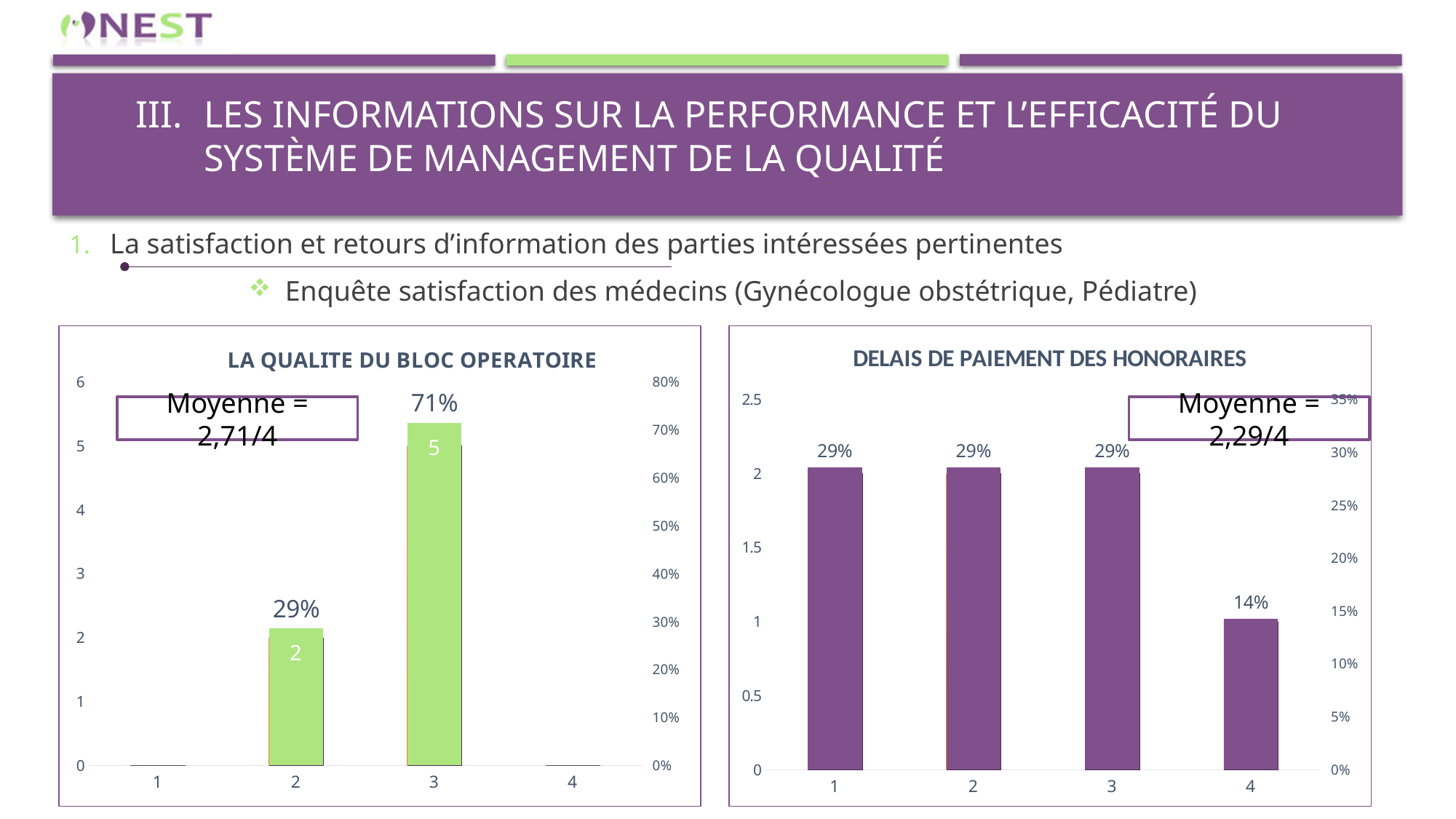
What type of chart is the chart titled 'DELAIS DE PAIEMENT DES HONORAIRES'? bar chart In the chart titled 'DELAIS DE PAIEMENT DES HONORAIRES', what is the average (Moyenne) shown in the box? 2,29/4 In the chart titled 'LA QUALITE DU BLOC OPERATOIRE', what count is printed inside the bar for category 2? 2 In the chart titled 'LA QUALITE DU BLOC OPERATOIRE', what percentage is shown for category 3? 71% In the chart titled 'LA QUALITE DU BLOC OPERATOIRE', what is the average (Moyenne) shown in the box? 2,71/4 In the chart titled 'DELAIS DE PAIEMENT DES HONORAIRES', which category has the lowest bar? 4 In the chart titled 'DELAIS DE PAIEMENT DES HONORAIRES', is the value for category 4 greater or less than 1.5 on the left axis? less In the chart titled 'DELAIS DE PAIEMENT DES HONORAIRES', how many categories are shown on the x axis? 4 In the chart titled 'LA QUALITE DU BLOC OPERATOIRE', what is the difference in percentage points between category 3 and category 2? 42 In the chart titled 'LA QUALITE DU BLOC OPERATOIRE', which category has the highest bar? 3 In the chart titled 'DELAIS DE PAIEMENT DES HONORAIRES', what is the difference in percentage points between category 1 and category 4? 15 In the chart titled 'DELAIS DE PAIEMENT DES HONORAIRES', what percentage is shown for category 4? 14%